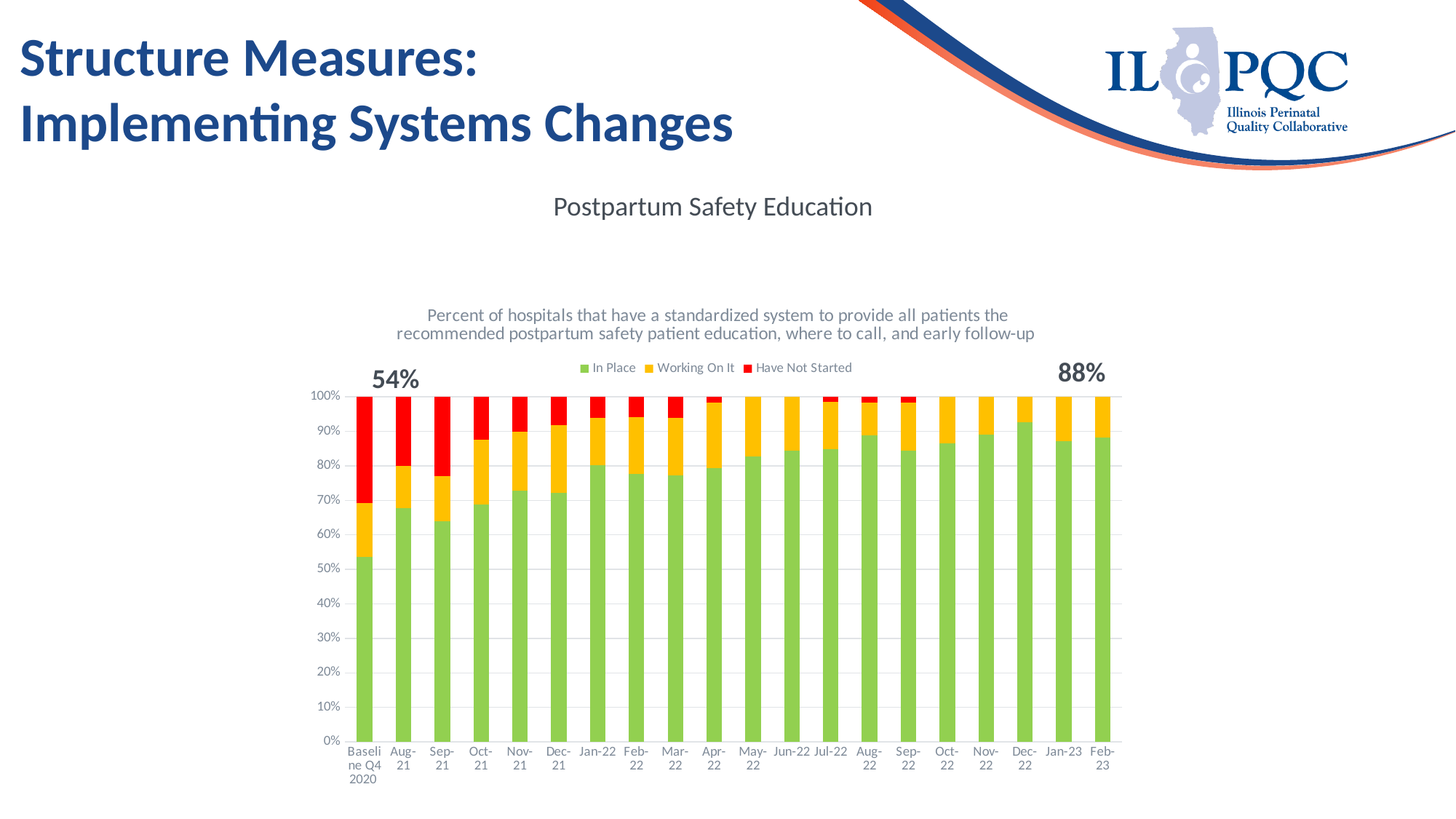
Is the In Place value for Jan-22 greater or less than 70%? greater Is the In Place value for Sep-21 greater or less than 70%? less Which period has the largest In Place (green) segment? Dec-22 How many time periods (bars) are shown on the x axis? 20 What are the three series listed in the legend? In Place, Working On It, Have Not Started What type of chart is shown on the slide? Stacked bar chart Which period has the largest Have Not Started (red) segment? Baseline Q4 2020 What is the difference between the labeled In Place percentage for Feb-23 and for Baseline Q4 2020? 34% Does the In Place (green) share generally rise or fall from Baseline Q4 2020 to Feb-23? Rise How many series does the legend list? 3 What is the In Place percentage labeled for the Baseline Q4 2020 bar? 54% What is the In Place percentage labeled for the Feb-23 bar? 88%